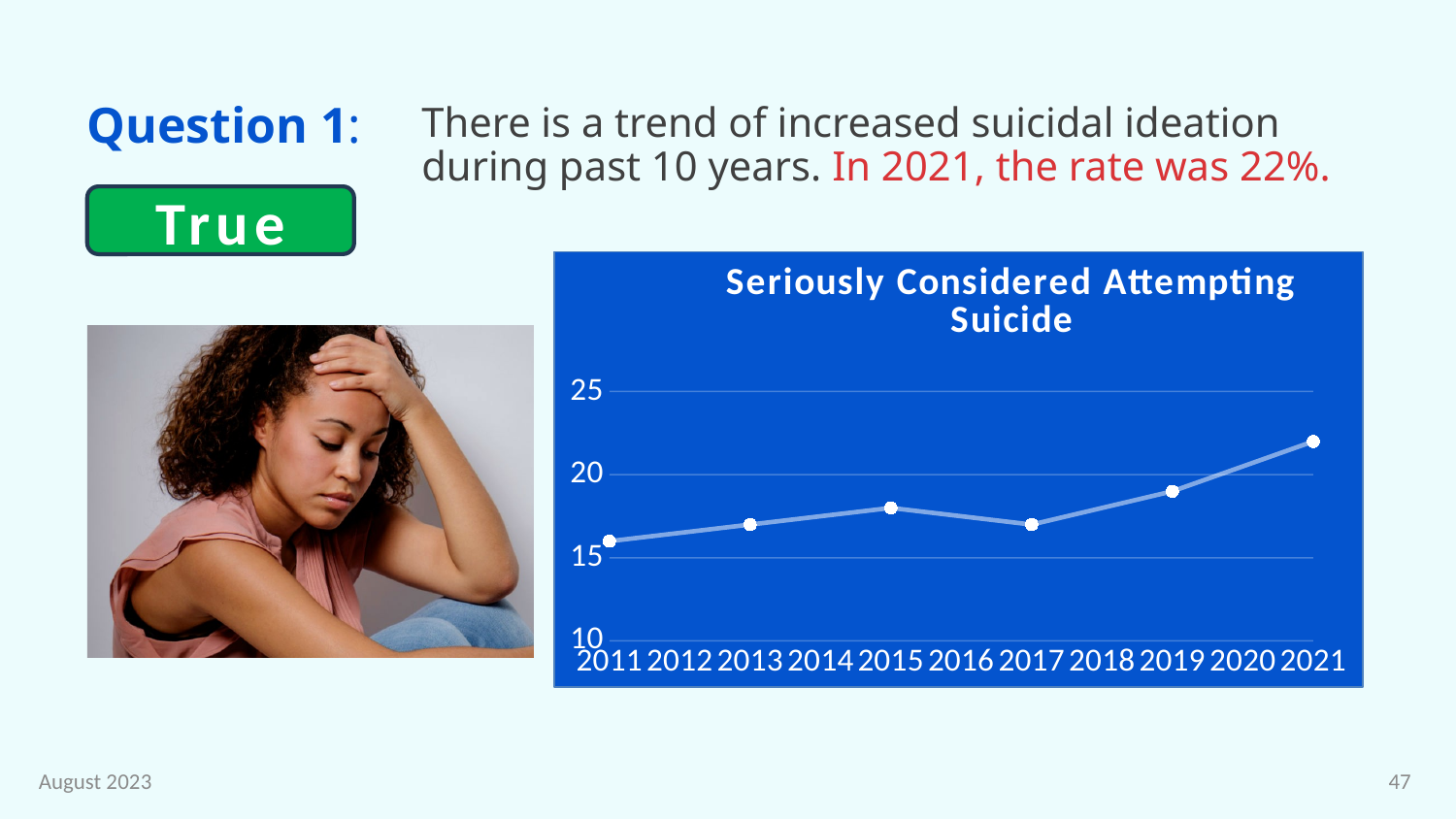
Is the value for 2011 greater or less than 20? less Is the value for 2015 greater or less than 20? less Which is larger, the value for 2019 or the value for 2021? 2021 Do the values generally rise or fall from 2011 to 2021? rise Is the value for 2021 greater or less than 20? greater Which year has the highest value in the chart? 2021 What is the title of the chart? Seriously Considered Attempting Suicide Which year has the lowest value in the chart? 2011 Which is larger, the value for 2015 or the value for 2017? 2015 How many data points are plotted on the line? 6 What kind of chart is shown on the slide? line chart